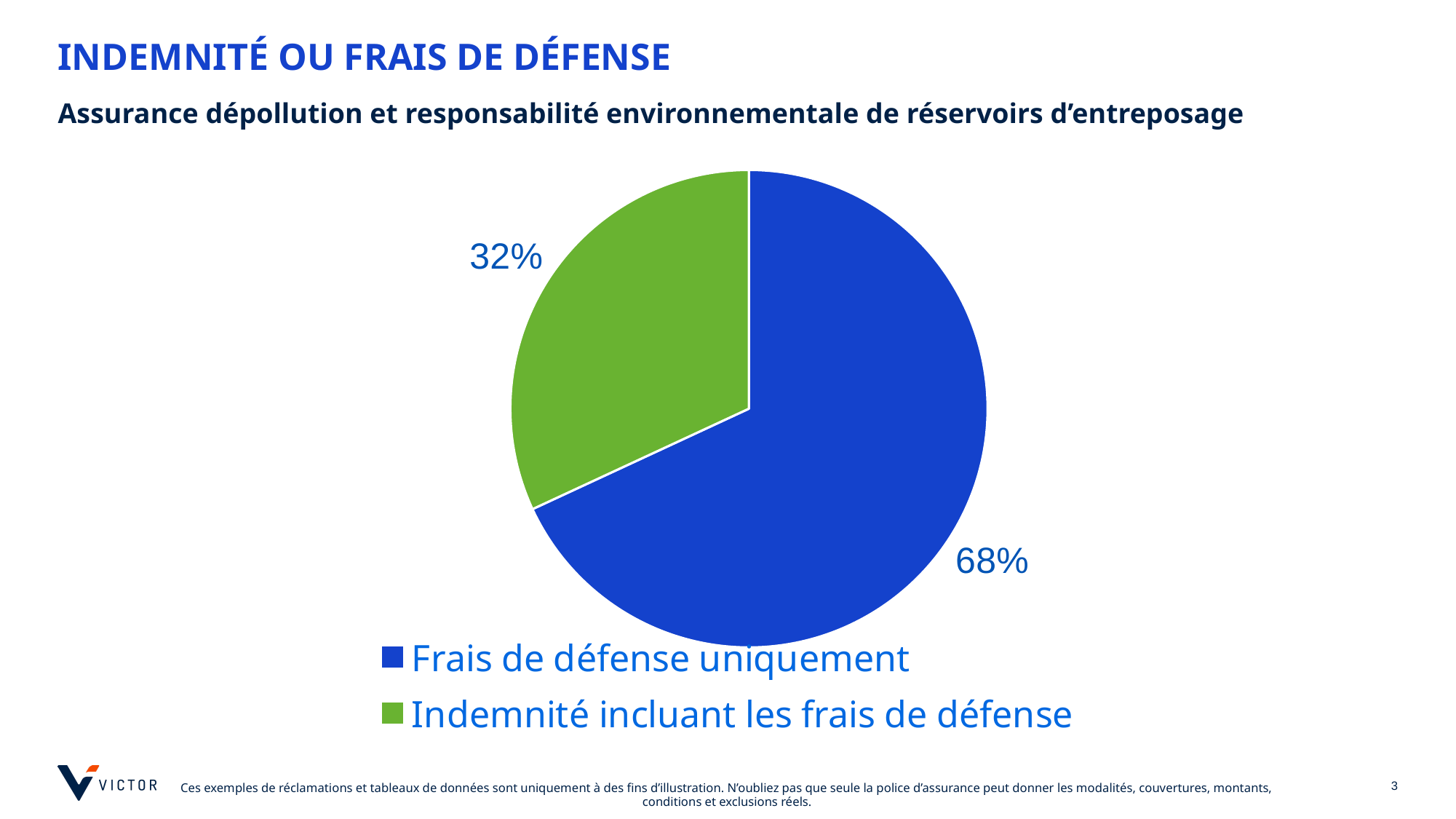
How many slices does the pie chart have? 2 What share of the pie is labelled "Frais de défense uniquement"? 68% What colour is the "Indemnité incluant les frais de défense" slice? green Which slice of the pie is the largest? Frais de défense uniquement What is the difference in percentage points between the "Frais de défense uniquement" slice and the "Indemnité incluant les frais de défense" slice? 36 Which slice of the pie is the smallest? Indemnité incluant les frais de défense What kind of chart is shown on the slide? pie chart Which is larger: the "Frais de défense uniquement" slice or the "Indemnité incluant les frais de défense" slice? Frais de défense uniquement What colour is the "Frais de défense uniquement" slice? blue How many entries does the legend list? 2 What share of the pie is labelled "Indemnité incluant les frais de défense"? 32%